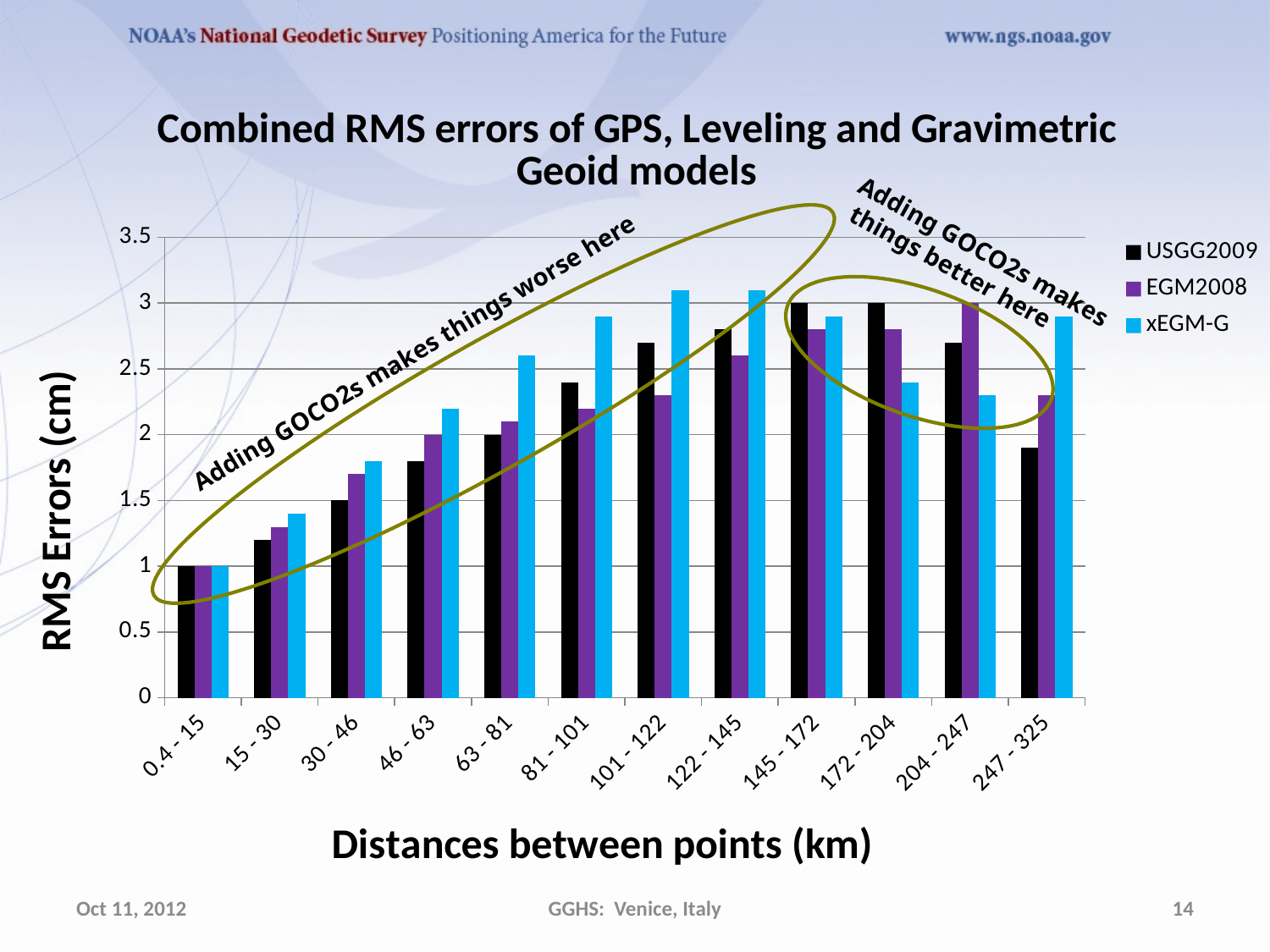
How many distance categories are shown on the x axis? 12 What kind of chart is shown on the slide? bar chart In the 247 - 325 km category, which series has the larger RMS error, USGG2009 or xEGM-G? xEGM-G Is the RMS error for xEGM-G in the 81 - 101 km category greater or less than 2.5? greater What is the RMS error for USGG2009 in the 145 - 172 km category? 3 In the 204 - 247 km category, which series has the larger RMS error, EGM2008 or xEGM-G? EGM2008 What is the RMS error for EGM2008 in the 46 - 63 km category? 2 What is the RMS error for USGG2009 in the 0.4 - 15 km category? 1 What is the label of the y axis? RMS Errors (cm) Do the USGG2009 RMS errors rise or fall from the 0.4 - 15 km category to the 145 - 172 km category? rise Which distance category has the lowest RMS error for xEGM-G? 0.4 - 15 How many series does the legend list? 3